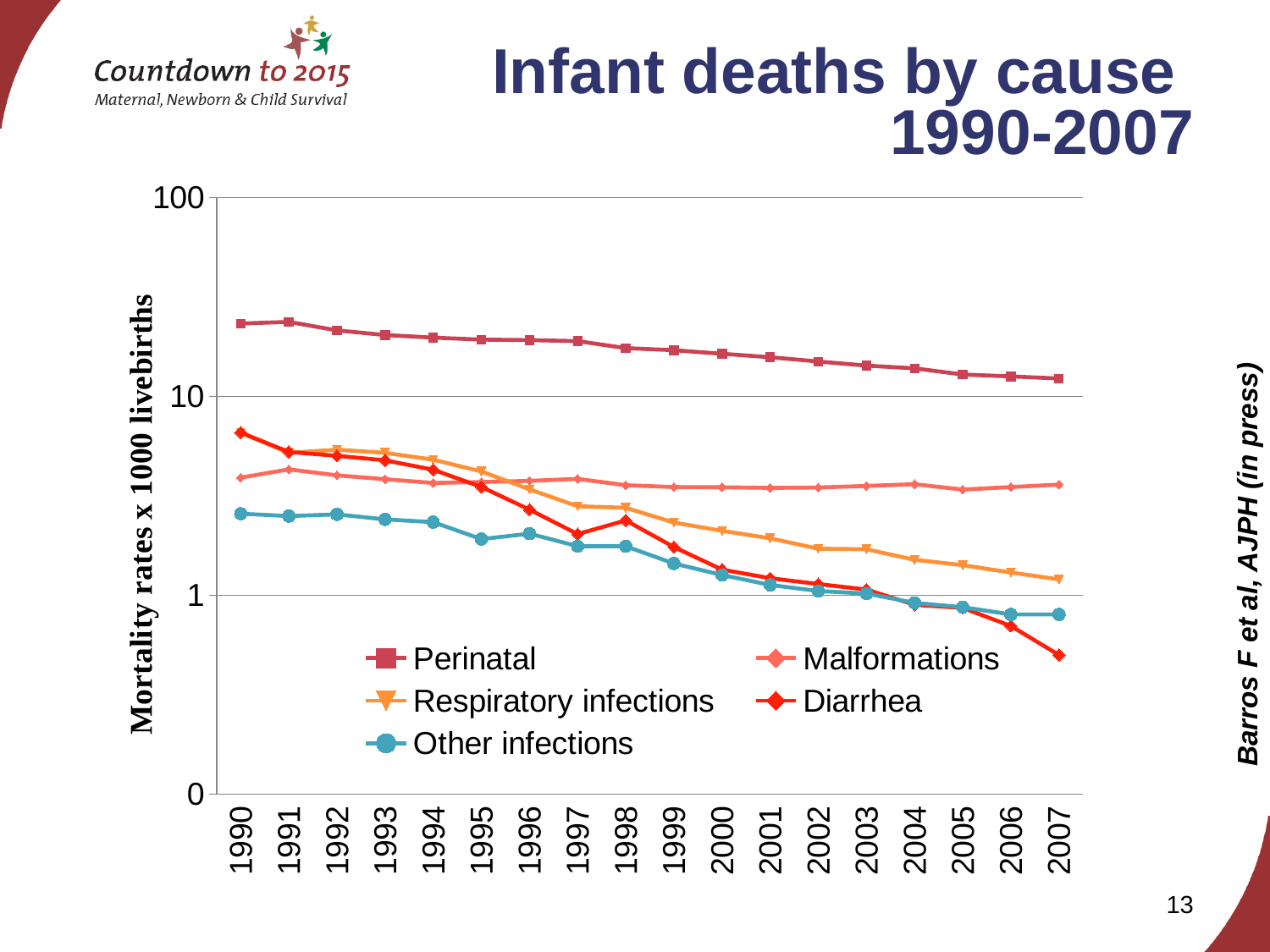
In 2007, which is larger: the mortality rate for Respiratory infections or for Diarrhea? Respiratory infections Which cause of infant death has the lowest mortality rate in 2007? Diarrhea How many years are plotted along the x axis? 18 Is the Perinatal mortality rate in 1990 greater or less than 10? greater What kind of chart is shown on the slide? Line chart Does the Diarrhea mortality rate rise or fall from 1990 to 2007? Fall How many series does the legend list? 5 Which cause of infant death has the highest mortality rate in 2007? Perinatal Is the Diarrhea mortality rate in 2007 greater or less than 1? less In 1990, which is larger: the mortality rate for Diarrhea or for Other infections? Diarrhea Which cause of infant death has the lowest mortality rate in 1990? Other infections Is the Malformations mortality rate in 2007 greater or less than 10? less